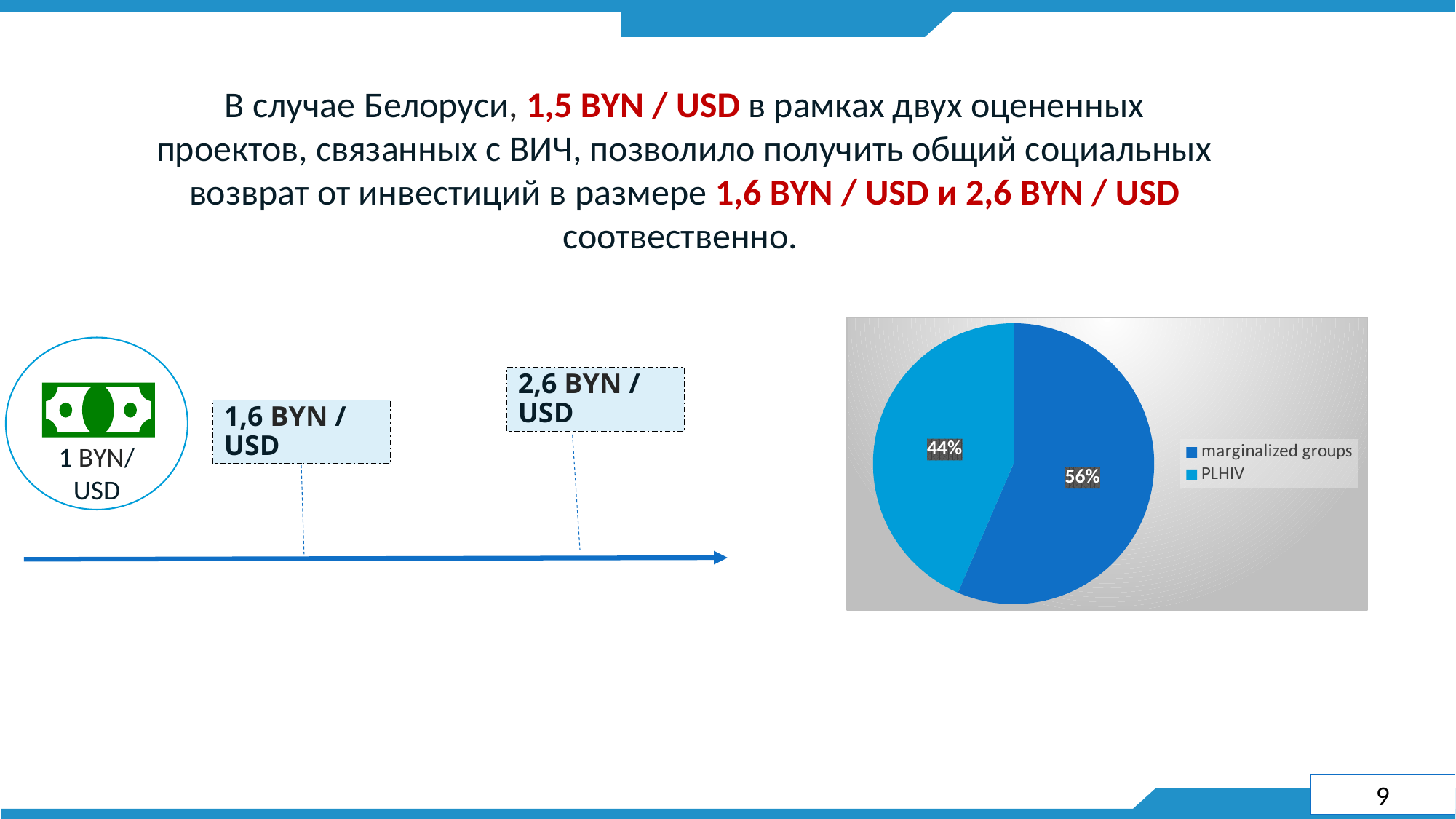
Which slice of the pie chart is the largest? marginalized groups What share of the pie chart is labelled for marginalized groups? 56% Which is larger in the pie chart: the marginalized groups slice or the PLHIV slice? marginalized groups How many entries does the legend of the pie chart list? 2 What kind of chart is shown on the right side of the slide? pie chart What are the two legend entries of the pie chart? marginalized groups, PLHIV How many slices does the pie chart have? 2 Is the share for PLHIV in the pie chart greater or less than 50%? less Which slice of the pie chart is the smallest? PLHIV Which legend entry in the pie chart is shown in the lighter blue colour? PLHIV What is the difference in percentage points between the marginalized groups slice and the PLHIV slice? 12 What share of the pie chart is labelled for PLHIV? 44%